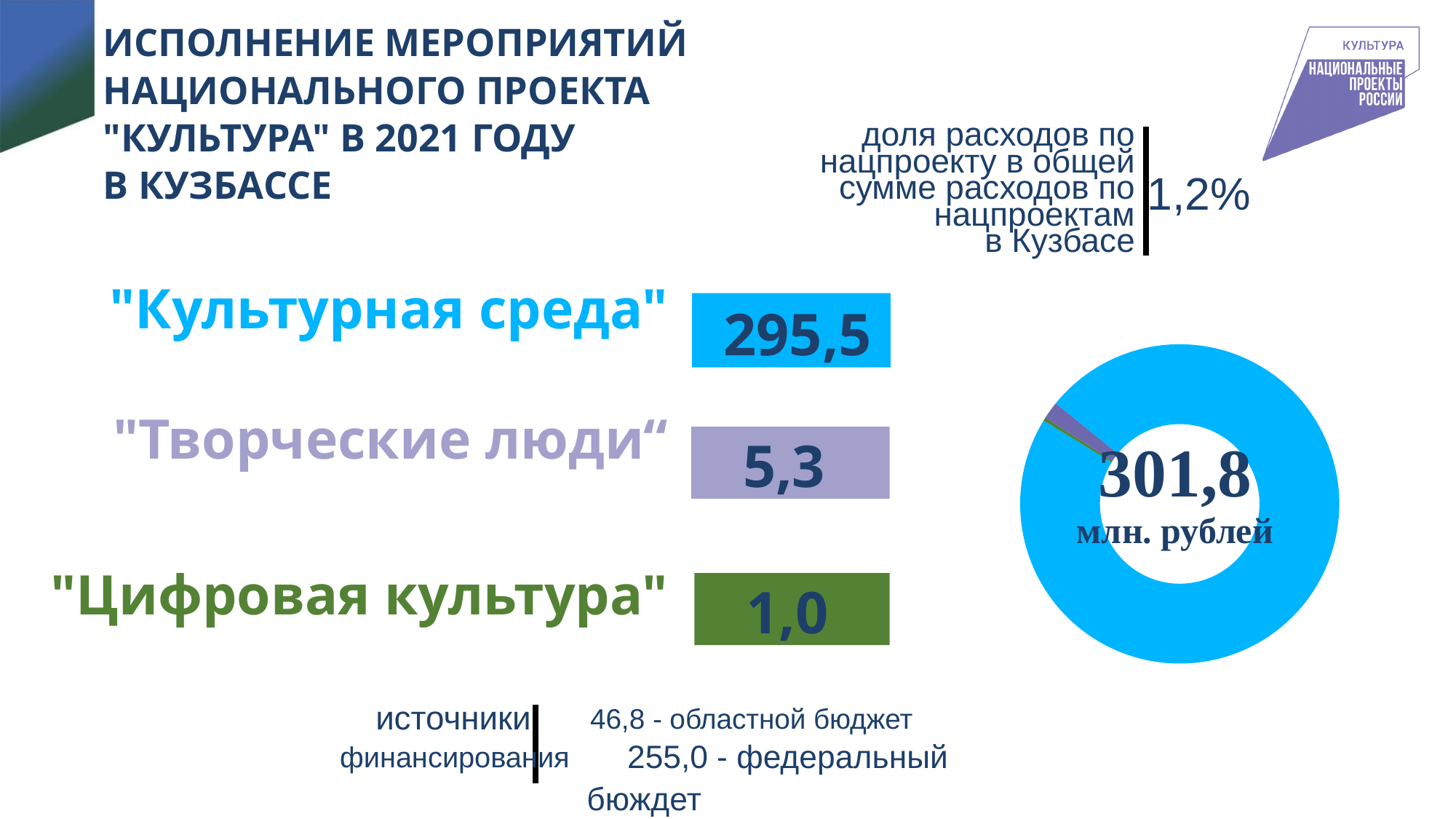
Which of the three project areas has the lowest value? "Цифровая культура" How many segments does the doughnut chart have? 3 What value is shown for "Творческие люди"? 5,3 Which of the three project areas has the highest value? "Культурная среда" What share of the doughnut chart total (301,8) does "Культурная среда" (295,5) represent, to one decimal place? 97,9% What value is shown for "Цифровая культура"? 1,0 What kind of chart is shown on the right side of the slide? doughnut (pie) chart Which colour segment takes up almost the entire doughnut chart? blue What is the difference between the values for "Творческие люди" and "Цифровая культура"? 4,3 Which is larger, the value for "Творческие люди" or for "Цифровая культура"? "Творческие люди" What value is shown for "Культурная среда"? 295,5 What total value is printed in the centre of the doughnut chart? 301,8 млн. рублей